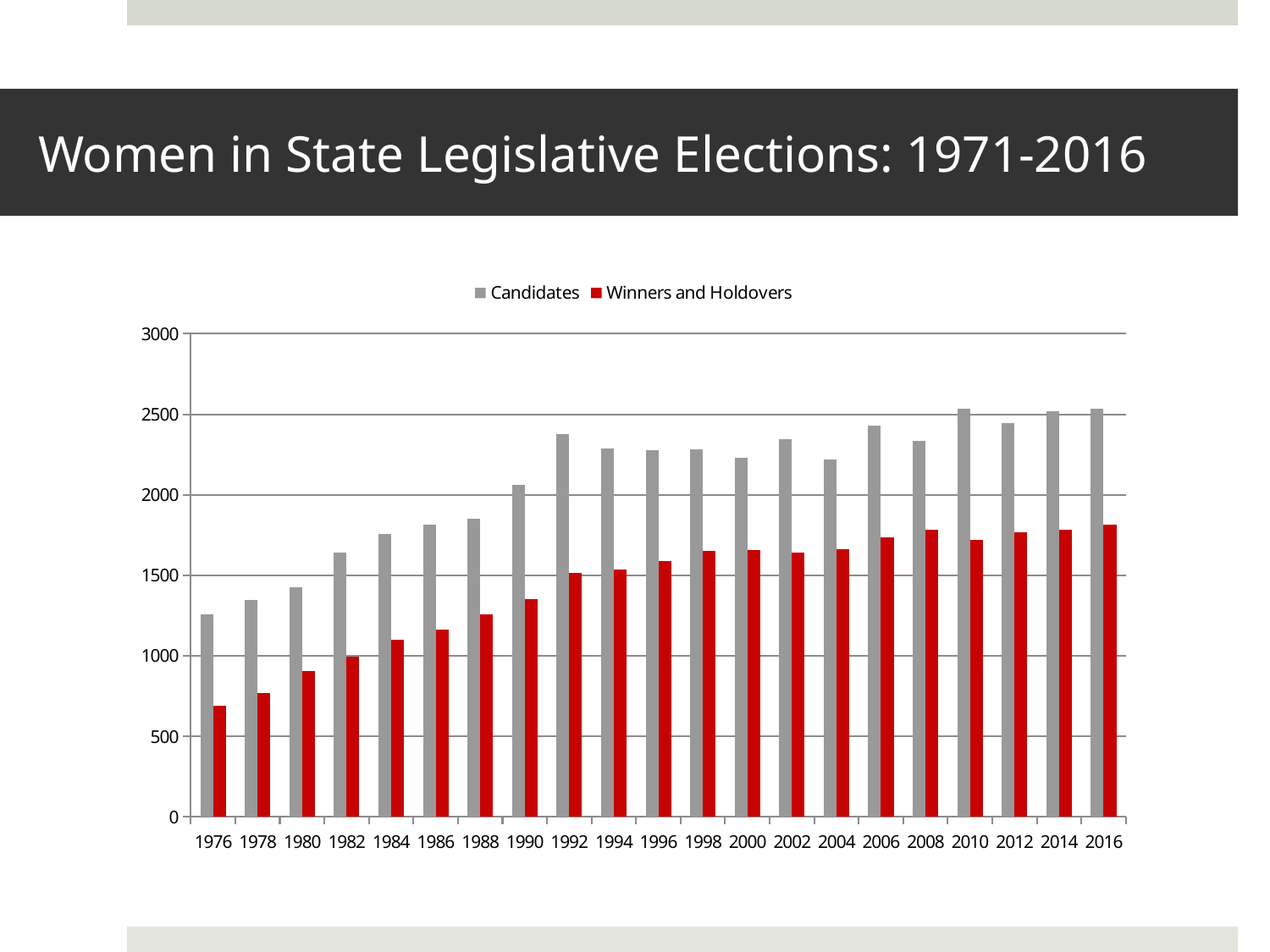
Is the value for Candidates in 1992 greater or less than 2000? greater Which year has the lowest value for Winners and Holdovers? 1976 What colour are the bars for Winners and Holdovers? red How many years are shown along the x axis? 21 Which is larger in 1976, Candidates or Winners and Holdovers? Candidates What kind of chart is shown on the slide? bar chart Is the value for Winners and Holdovers in 1990 greater or less than 1500? less Is the value for Candidates in 1976 greater or less than 1500? less How many series does the legend list? 2 Which year has the lowest value for Candidates? 1976 Do the values for Winners and Holdovers generally rise or fall from 1976 to 2016? rise